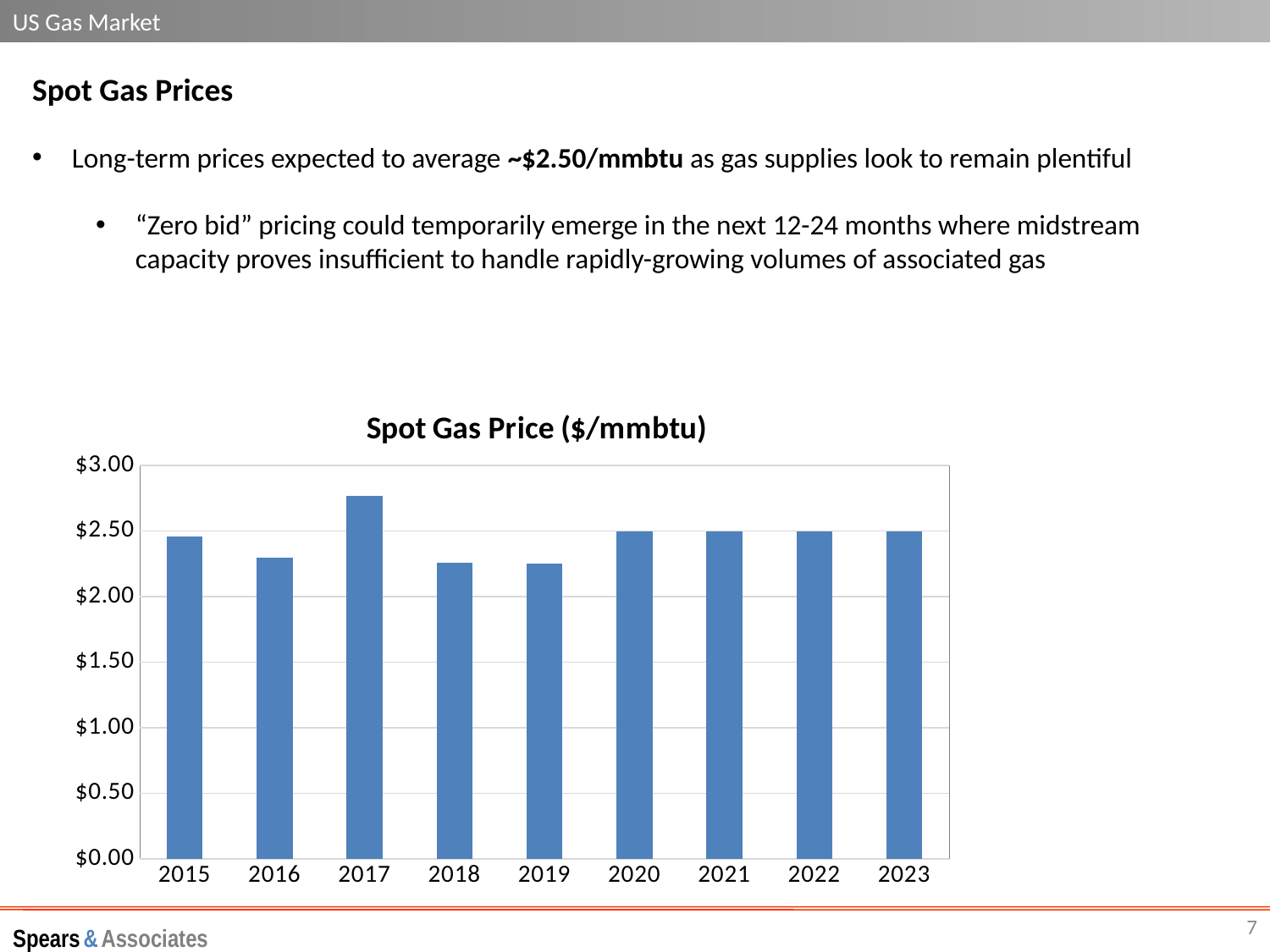
Which year has the larger spot gas price, 2015 or 2016? 2015 Is the spot gas price for 2019 greater or less than $2.50? less Is the spot gas price for 2018 greater or less than $2.00? greater What kind of chart is shown on the slide? bar chart Is the spot gas price for 2016 greater or less than $2.50? less Do spot gas prices rise or fall from 2017 to 2019? fall Which year has the larger spot gas price, 2016 or 2017? 2017 How many years are shown on the x axis of the chart? 9 What is the title of the chart? Spot Gas Price ($/mmbtu) Which year has the highest spot gas price in the chart? 2017 What is the spot gas price shown for 2021? $2.50